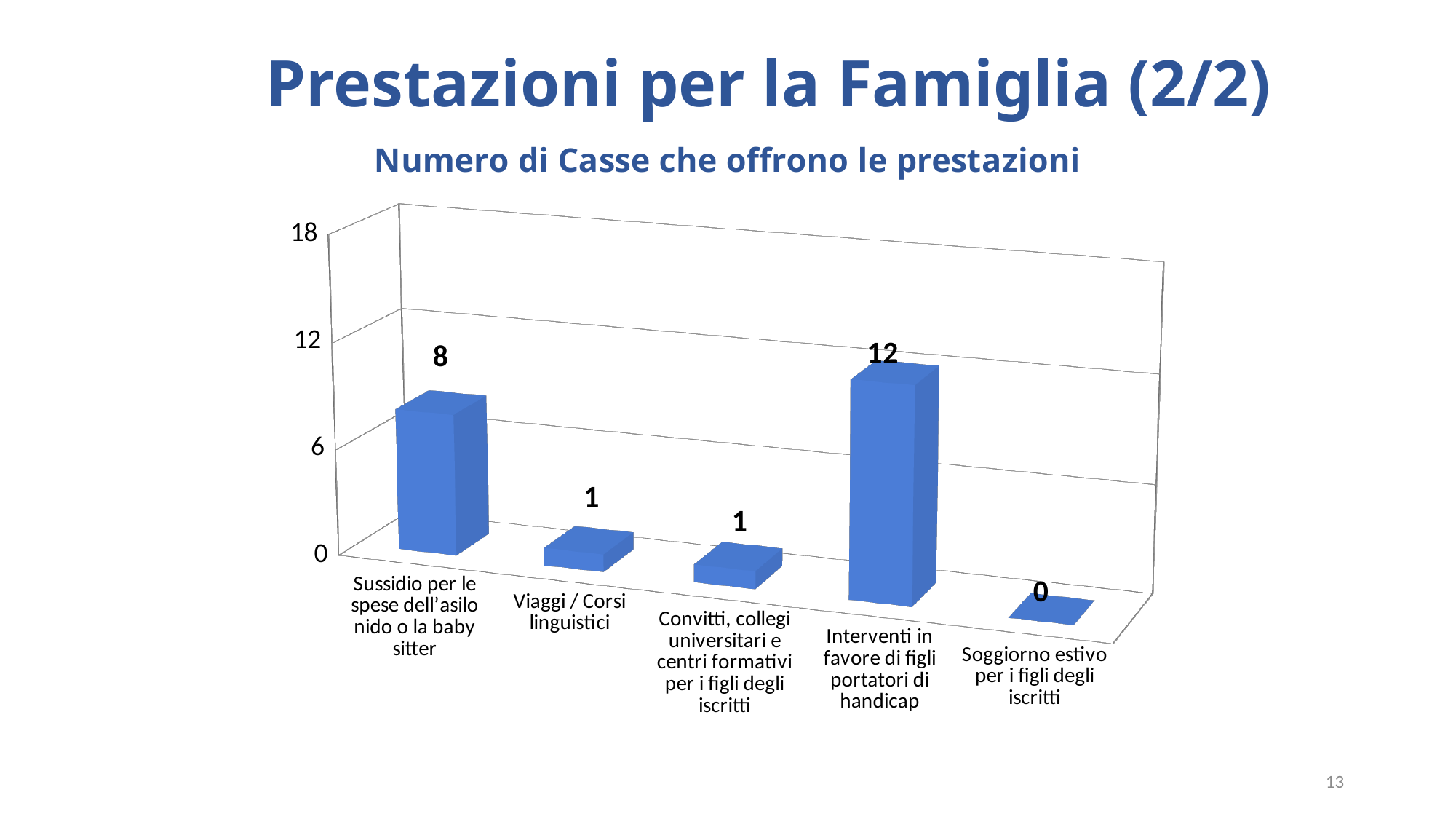
What is the value for "Soggiorno estivo per i figli degli iscritti"? 0 Is the value for "Interventi in favore di figli portatori di handicap" greater or less than 6? greater What is the value for "Viaggi / Corsi linguistici"? 1 Which category has the lowest value? Soggiorno estivo per i figli degli iscritti How many categories are shown on the chart? 5 What is the difference between the values for "Interventi in favore di figli portatori di handicap" and "Sussidio per le spese dell'asilo nido o la baby sitter"? 4 What kind of chart is shown on the slide? Bar chart Which is larger: the value for "Sussidio per le spese dell'asilo nido o la baby sitter" or the value for "Convitti, collegi universitari e centri formativi per i figli degli iscritti"? Sussidio per le spese dell'asilo nido o la baby sitter What is the value for "Interventi in favore di figli portatori di handicap"? 12 Which category has the highest value? Interventi in favore di figli portatori di handicap What is the title of the chart? Numero di Casse che offrono le prestazioni What is the value for "Sussidio per le spese dell'asilo nido o la baby sitter"? 8